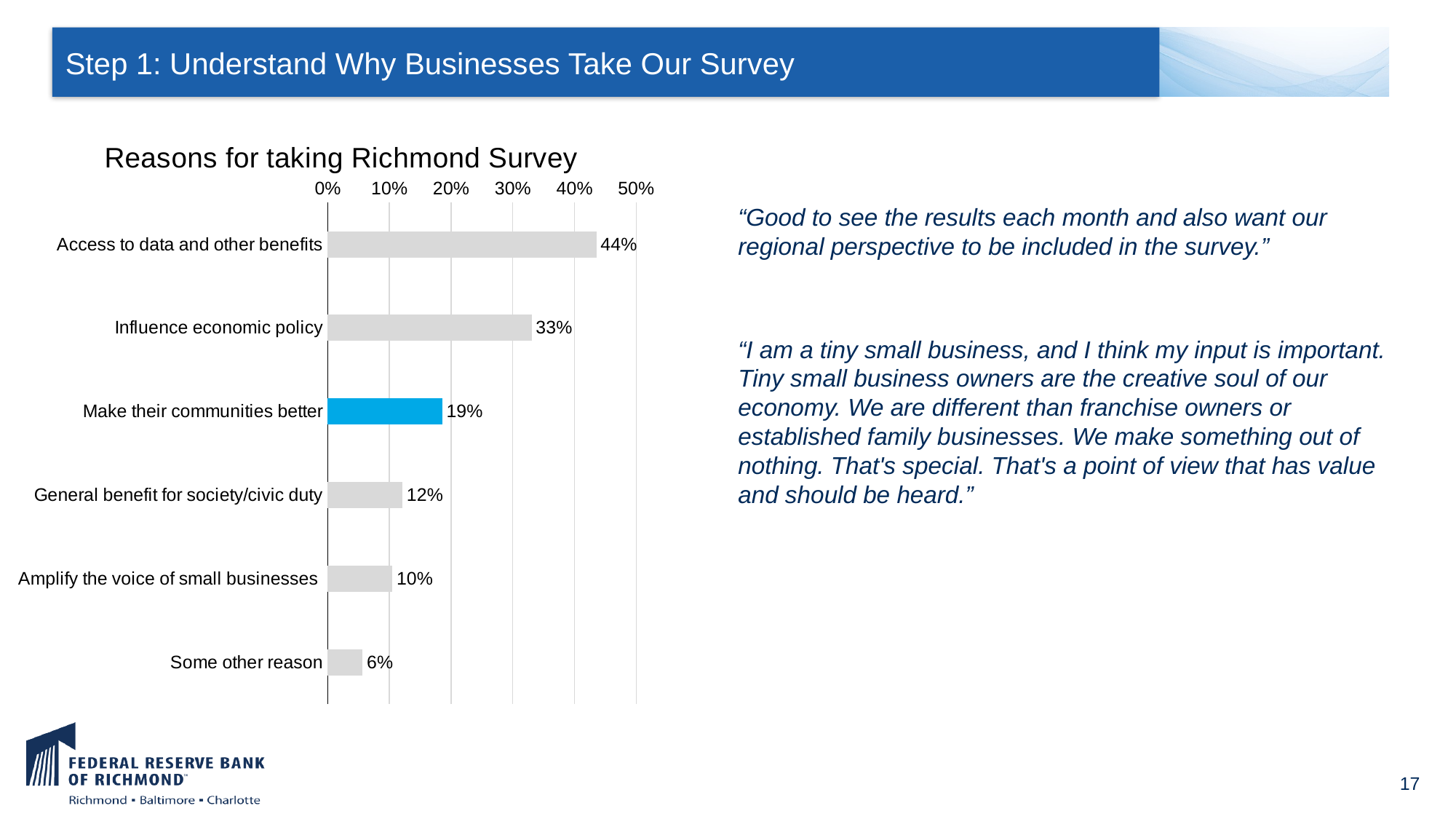
Which bar in the chart is highlighted in blue rather than grey? Make their communities better What is the difference in percentage points between 'Access to data and other benefits' and 'Influence economic policy'? 11 percentage points What percentage is shown for 'Some other reason'? 6% How many reasons are listed in the chart? 6 What is the value shown for 'Make their communities better'? 19% Is the value for 'Influence economic policy' greater or less than 30%? greater Which reason for taking the Richmond Survey has the highest percentage? Access to data and other benefits What type of chart is used to show the reasons for taking the Richmond Survey? Bar chart What is the title of the chart? Reasons for taking Richmond Survey Which has a higher value: 'General benefit for society/civic duty' or 'Amplify the voice of small businesses'? General benefit for society/civic duty Which reason has the lowest percentage? Some other reason What percentage of respondents cited 'Access to data and other benefits' as a reason for taking the Richmond Survey? 44%